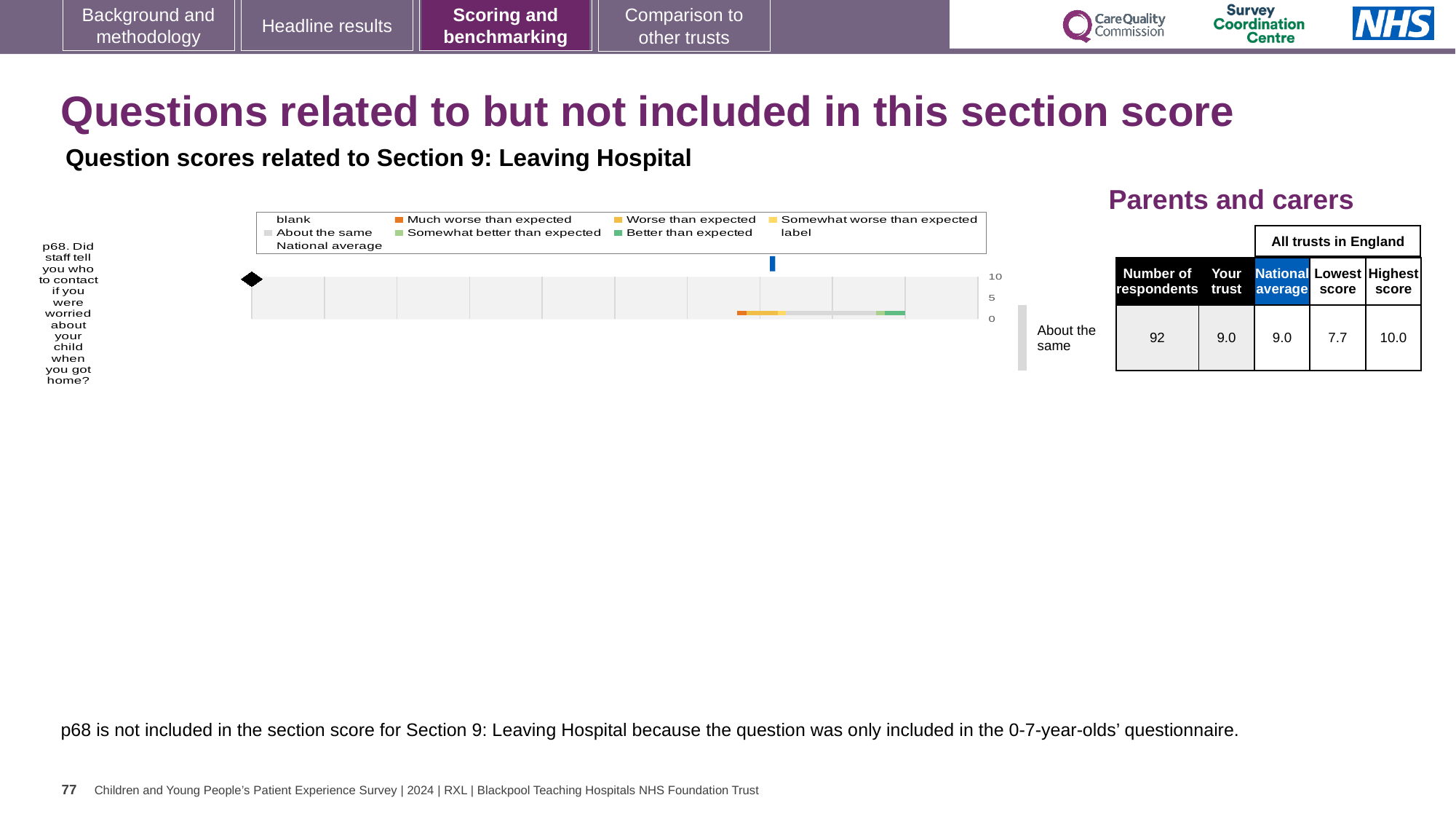
What is the highest value shown on the chart's axis? 10 According to the table beside the chart, what is the lowest score among all trusts in England for p68? 7.7 Which question is plotted in the chart? p68. Did staff tell you who to contact if you were worried about your child when you got home? What rating label is shown next to the chart for question p68? About the same According to the table beside the chart, what is the national average score for p68? 9.0 According to the table beside the chart, what is the highest score among all trusts in England for p68? 10.0 How many respondents answered question p68, according to the table beside the chart? 92 What is the difference between the highest score and the lowest score for p68 in the table beside the chart? 2.3 What kind of chart is shown on the slide for question p68? bar chart How many questions (categories) are plotted in the chart? 1 According to the table beside the chart, what is the 'Your trust' score for p68? 9.0 Is the 'Your trust' score for p68 larger than, smaller than, or equal to the national average? equal